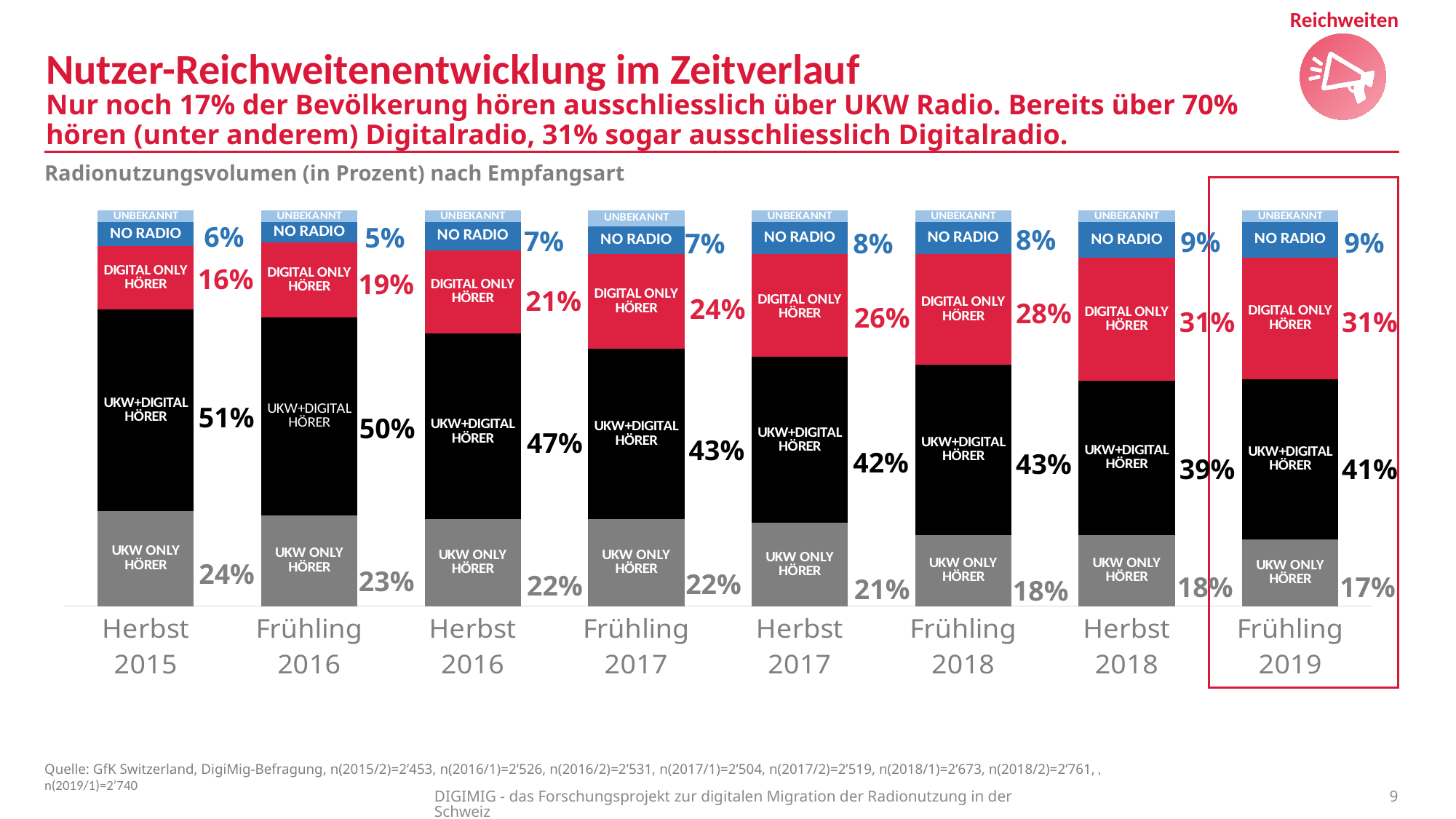
What is the value for UKW+DIGITAL HÖRER in Herbst 2016? 47% What kind of chart is shown on the slide? Stacked bar chart How many time periods are shown on the x axis? 8 What is the value for UKW ONLY HÖRER in Frühling 2019? 17% In which period is the UKW+DIGITAL HÖRER value highest? Herbst 2015 Which period is highlighted with a red box on the chart? Frühling 2019 What is the value for DIGITAL ONLY HÖRER in Herbst 2015? 16% In which period is the DIGITAL ONLY HÖRER value lowest? Herbst 2015 Does the UKW ONLY HÖRER value rise or fall from Herbst 2015 to Frühling 2019? Fall What is the value for NO RADIO in Frühling 2016? 5% Which is larger: UKW ONLY HÖRER in Herbst 2015 or UKW ONLY HÖRER in Frühling 2019? Herbst 2015 What is the difference between the DIGITAL ONLY HÖRER values in Frühling 2019 and Herbst 2015? 15%